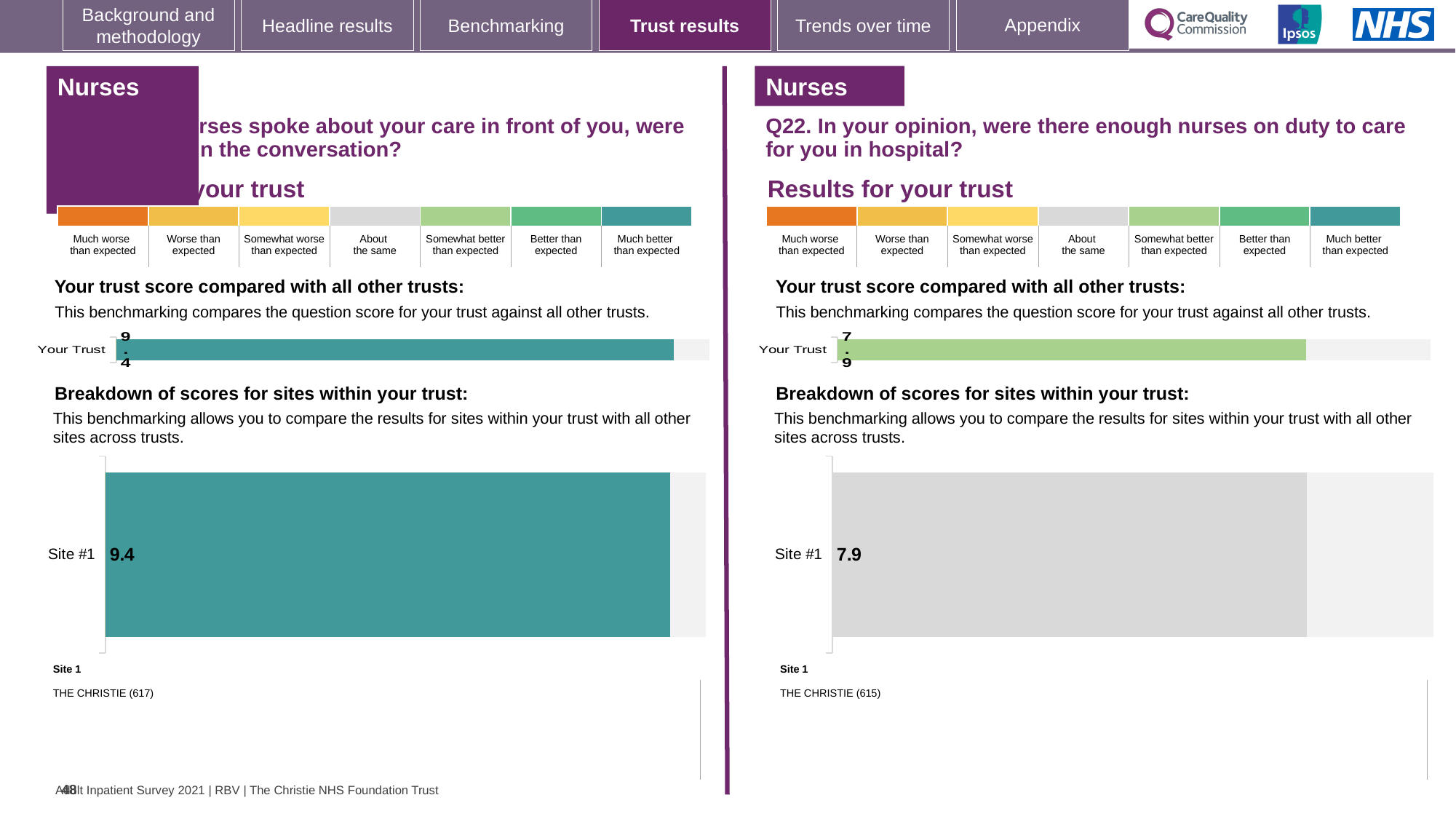
Which is larger: the Site #1 score in the left breakdown chart or the Site #1 score in the right (Q22) breakdown chart? The left chart (9.4) What is the difference between the Your Trust score on the left half of the slide and the Your Trust score on the right (Q22) half? 1.5 In the right (Q22) 'Breakdown of scores for sites within your trust' chart, what is the score for Site #1? 7.9 On the left half of the slide, what is the score shown for Your Trust in the 'Your trust score compared with all other trusts' chart? 9.4 In the right (Q22) breakdown chart, what colour is the Site #1 bar? Grey How many sites are shown in the right (Q22) 'Breakdown of scores for sites within your trust' chart? 1 On the right half of the slide (Q22), what is the score shown for Your Trust in the 'Your trust score compared with all other trusts' chart? 7.9 Which site name is listed under Site 1 for the left breakdown chart? THE CHRISTIE (617) What type of chart is used to show the Site #1 score in the left breakdown chart? Bar chart In the left breakdown chart, what colour is the Site #1 bar? Teal In the left 'Breakdown of scores for sites within your trust' chart, what is the score for Site #1? 9.4 Which site name is listed under Site 1 for the right (Q22) breakdown chart? THE CHRISTIE (615)